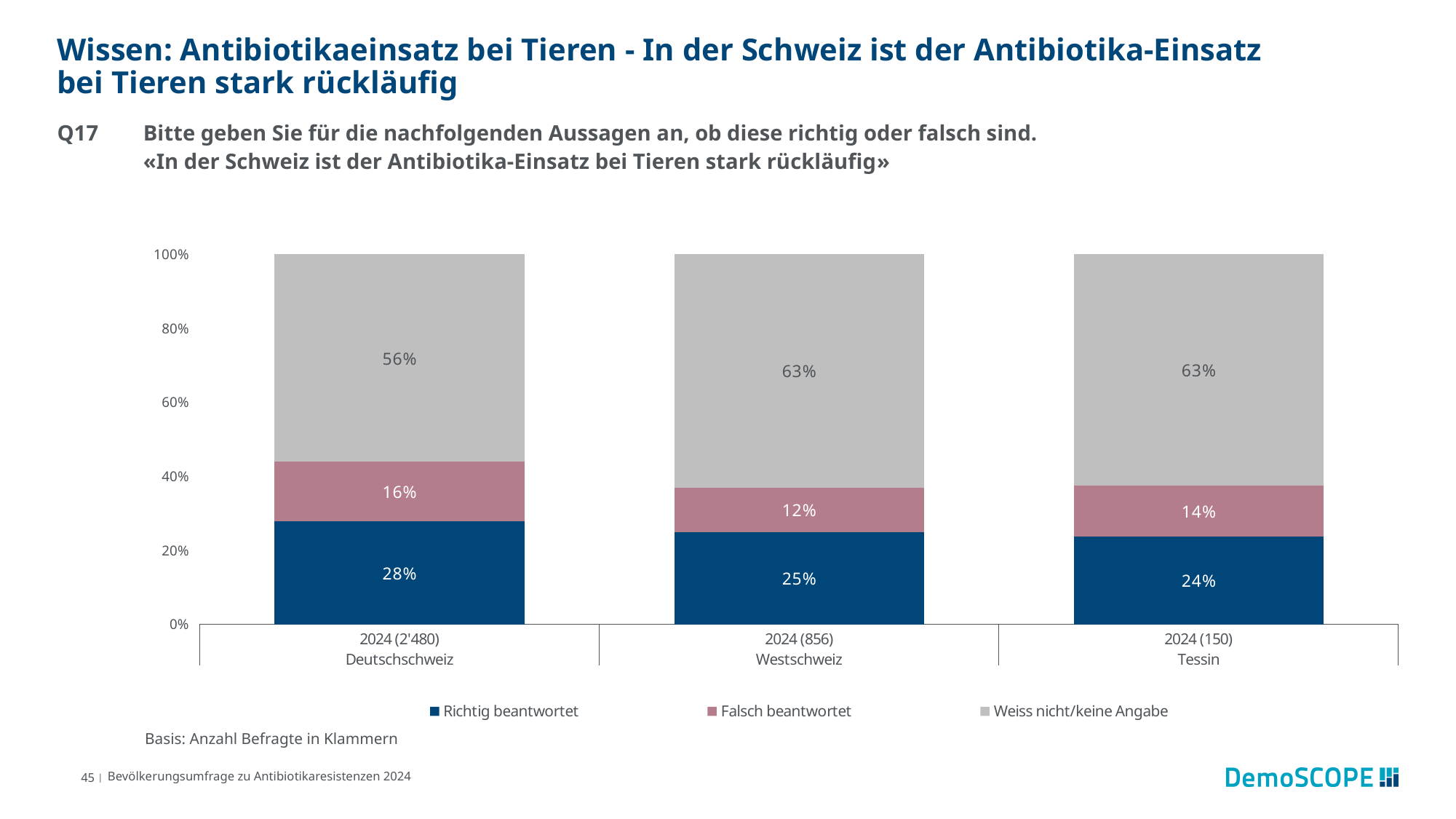
How many regions are shown on the x axis? 3 What is the combined share of 'Richtig beantwortet' and 'Falsch beantwortet' for Westschweiz? 37% How many series does the legend list? 3 What kind of chart is shown on the slide? Stacked bar chart Which is larger: the 'Weiss nicht/keine Angabe' share for Deutschschweiz or for Tessin? Tessin How many respondents are in the Tessin sample, as shown in parentheses on the x axis? 150 What percentage of respondents in Tessin answered incorrectly (Falsch beantwortet)? 14% Which region has the lowest share of 'Falsch beantwortet'? Westschweiz What is the difference between the 'Falsch beantwortet' shares of Deutschschweiz and Westschweiz? 4 percentage points Which region has the highest share of 'Richtig beantwortet'? Deutschschweiz What percentage of respondents in Deutschschweiz answered correctly (Richtig beantwortet)? 28% What is the 'Weiss nicht/keine Angabe' share for Westschweiz? 63%